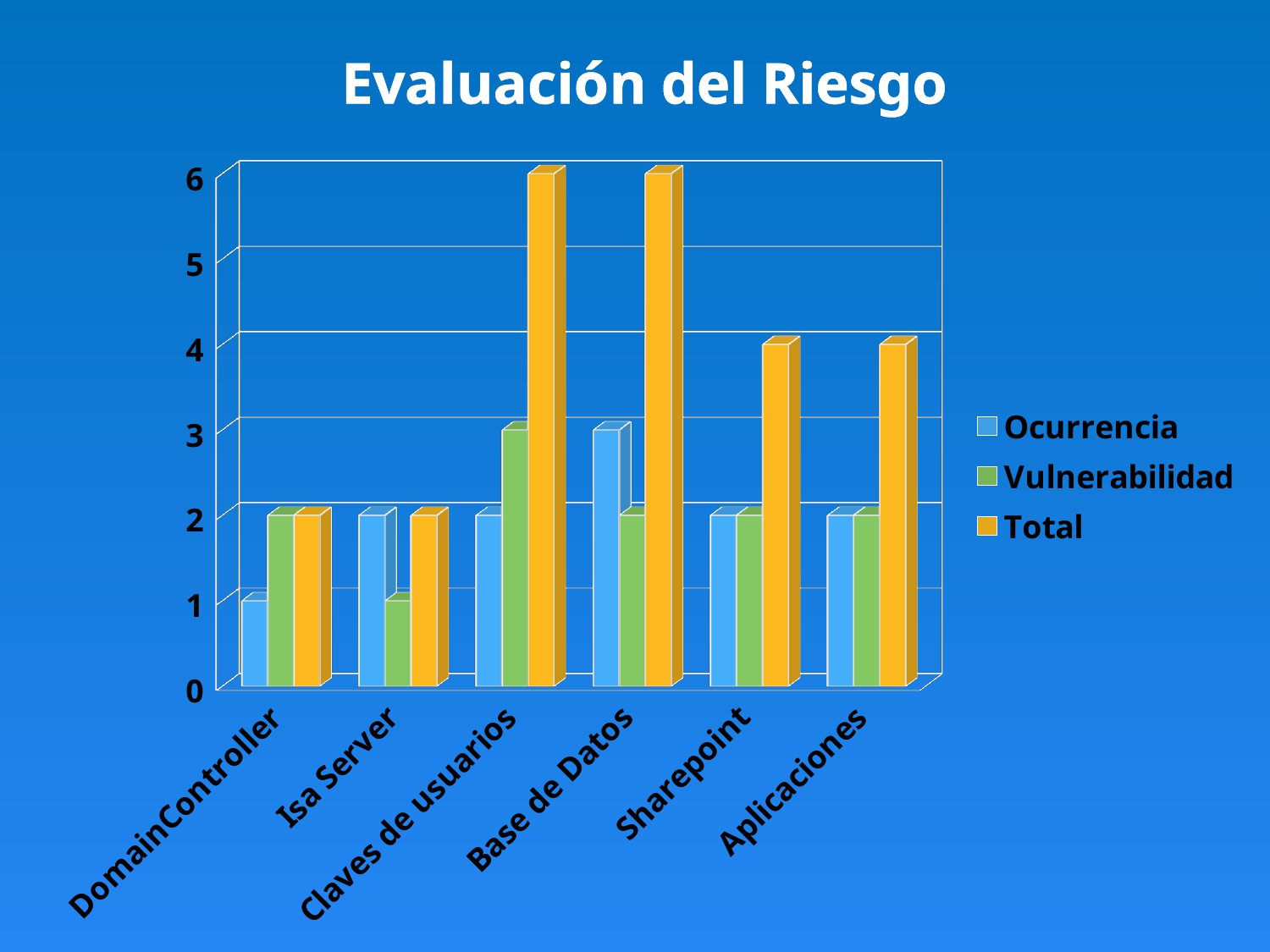
What is the Vulnerabilidad value for Isa Server? 1 What is the difference between the Total for Base de Datos and the Total for Aplicaciones? 2 What kind of chart is shown on the slide? bar chart Which is larger, the Total for Isa Server or the Total for Sharepoint? Sharepoint What is the Total value for Sharepoint? 4 How many series does the legend list? 3 Which category has the highest Vulnerabilidad value? Claves de usuarios What is the Ocurrencia value for Base de Datos? 3 How many categories are shown on the x axis? 6 What is the Total value for Claves de usuarios? 6 What is the title of the chart? Evaluación del Riesgo Which category has the lowest Ocurrencia value? DomainController